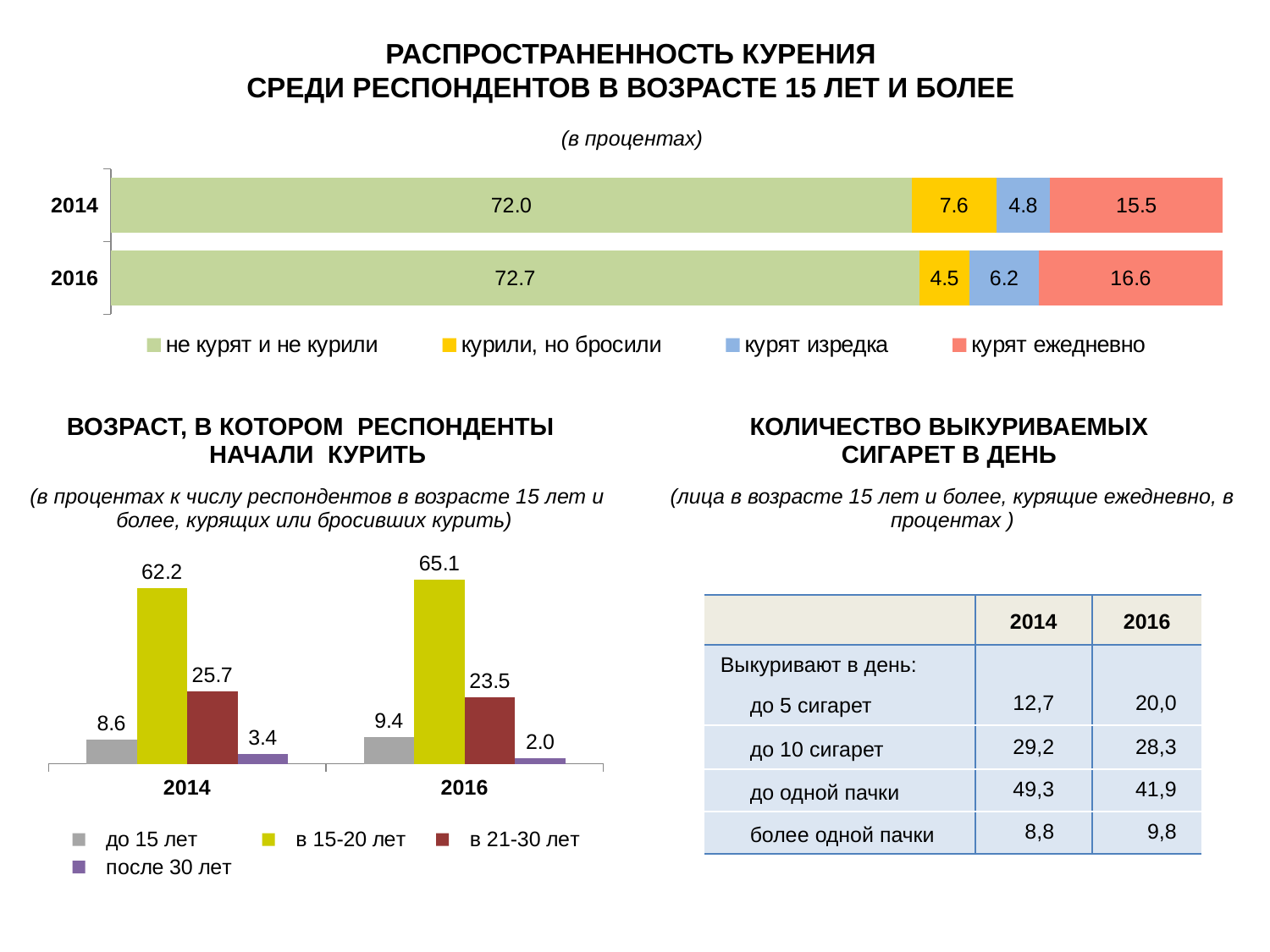
In the bottom-left chart (Возраст, в котором респонденты начали курить), how many year categories are shown on the x axis? 2 In the top chart (Распространенность курения), how many series does the legend list? 4 In the top chart (Распространенность курения), which is larger: 'курят изредка' in 2014 or in 2016? 2016 In the bottom-left chart (Возраст, в котором респонденты начали курить), what is the value for 'в 15-20 лет' in 2016? 65.1 In the top chart (Распространенность курения), what type of chart is shown? Stacked bar chart In the top chart (Распространенность курения), what is the total of the stacked bar for 2016? 100.0 In the top chart (Распространенность курения), what is the value for 'не курят и не курили' in 2016? 72.7 In the bottom-left chart (Возраст, в котором респонденты начали курить), what is the difference between 'в 21-30 лет' in 2014 and 2016? 2.2 In the bottom-left chart (Возраст, в котором респонденты начали курить), which age group has the lowest value in 2014? после 30 лет In the top chart (Распространенность курения), by how much did 'курили, но бросили' change from 2014 to 2016? 3.1 In the bottom-left chart (Возраст, в котором респонденты начали курить), which age group has the highest value in 2016? в 15-20 лет In the top chart (Распространенность курения), what is the value for 'курят ежедневно' in 2014? 15.5